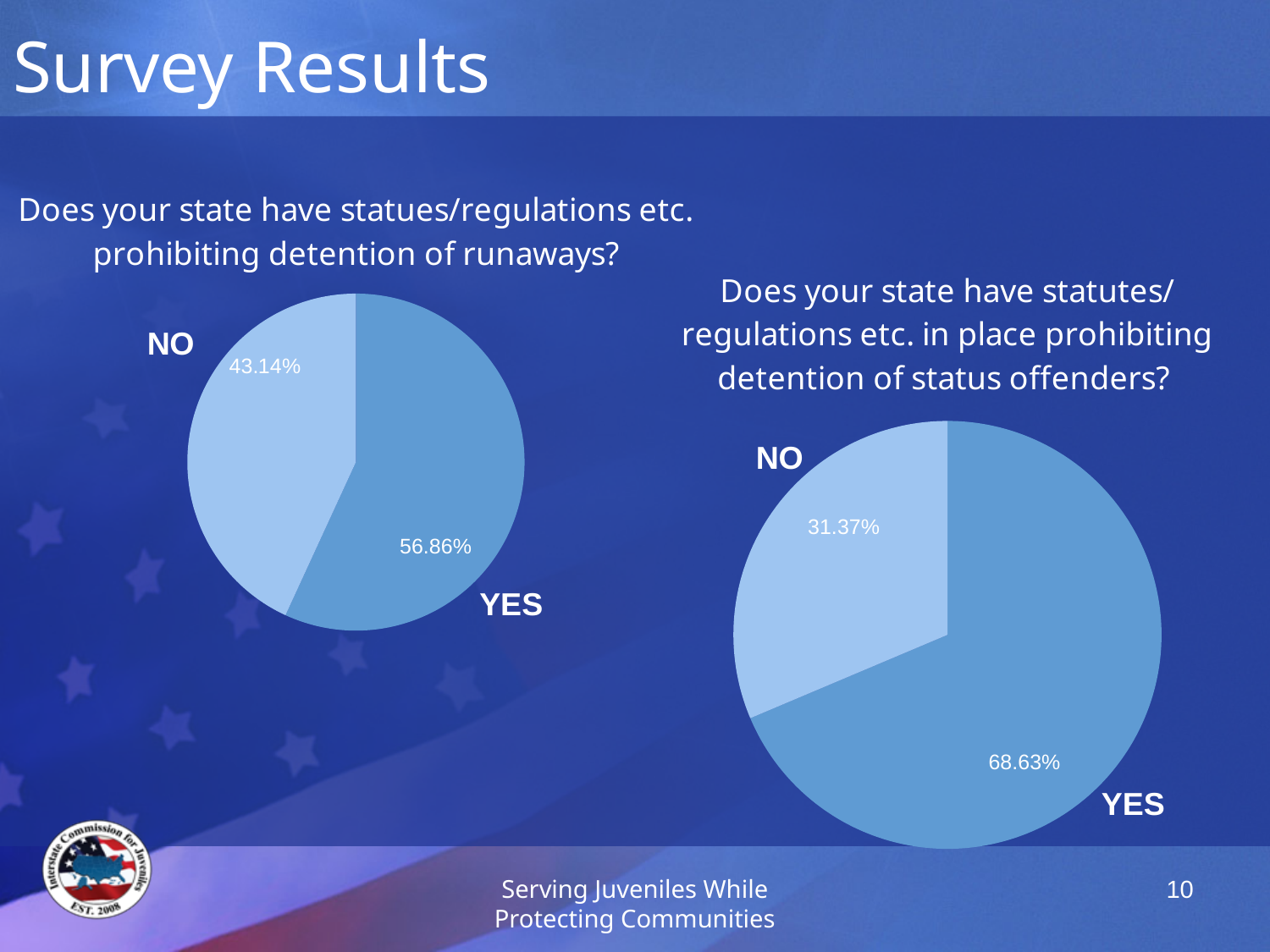
Is the YES share larger in the left pie chart (runaways) or the right pie chart (status offenders)? right pie chart (status offenders) What type of chart is used on the left of the slide? pie chart In the left pie chart about detention of runaways, which response has the larger share? YES How many pie charts are shown on the slide? 2 In the right pie chart about detention of status offenders, which response has the smaller share? NO In the left pie chart about detention of runaways, what percentage answered NO? 43.14% In the right pie chart about detention of status offenders, what percentage answered NO? 31.37% In the left pie chart about detention of runaways, what is the difference in percentage points between YES and NO? 13.72 In the left pie chart about detention of runaways, what percentage answered YES? 56.86% How many slices does the right pie chart about detention of status offenders have? 2 In the right pie chart about detention of status offenders, what is the difference in percentage points between YES and NO? 37.26 In the right pie chart about detention of status offenders, what percentage answered YES? 68.63%